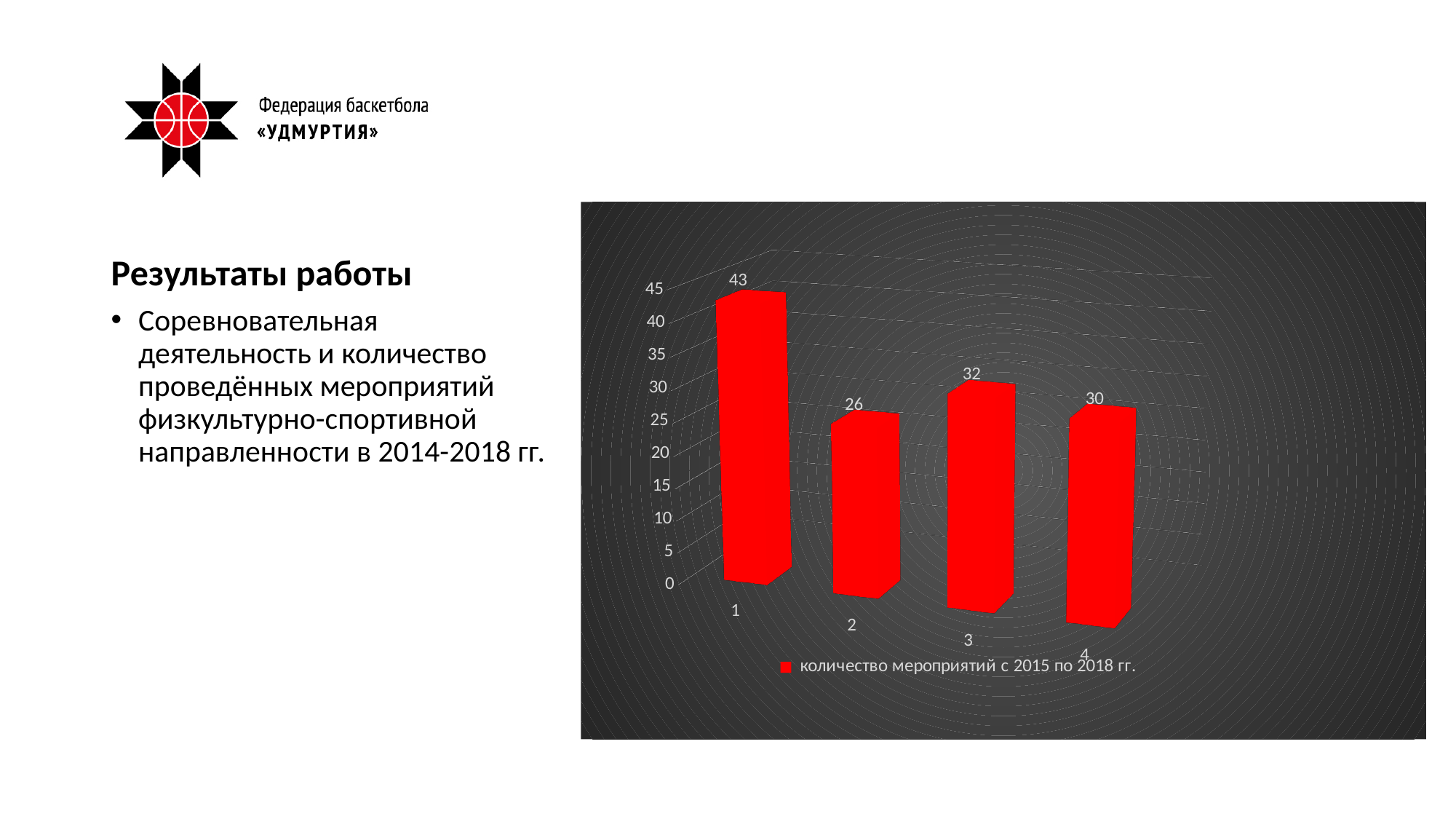
What is the value for category 2? 26 What is the difference between the values for category 1 and category 2? 17 What is the value for category 3? 32 How many series does the legend list? 1 Which category has the highest value? 1 What kind of chart is shown on the slide? bar chart How many bars are shown in the chart? 4 Which category has the lowest value? 2 What is the legend entry of the chart? количество мероприятий с 2015 по 2018 гг. Which is larger, the value for category 3 or category 4? category 3 What is the value for category 4? 30 What is the value for category 1? 43